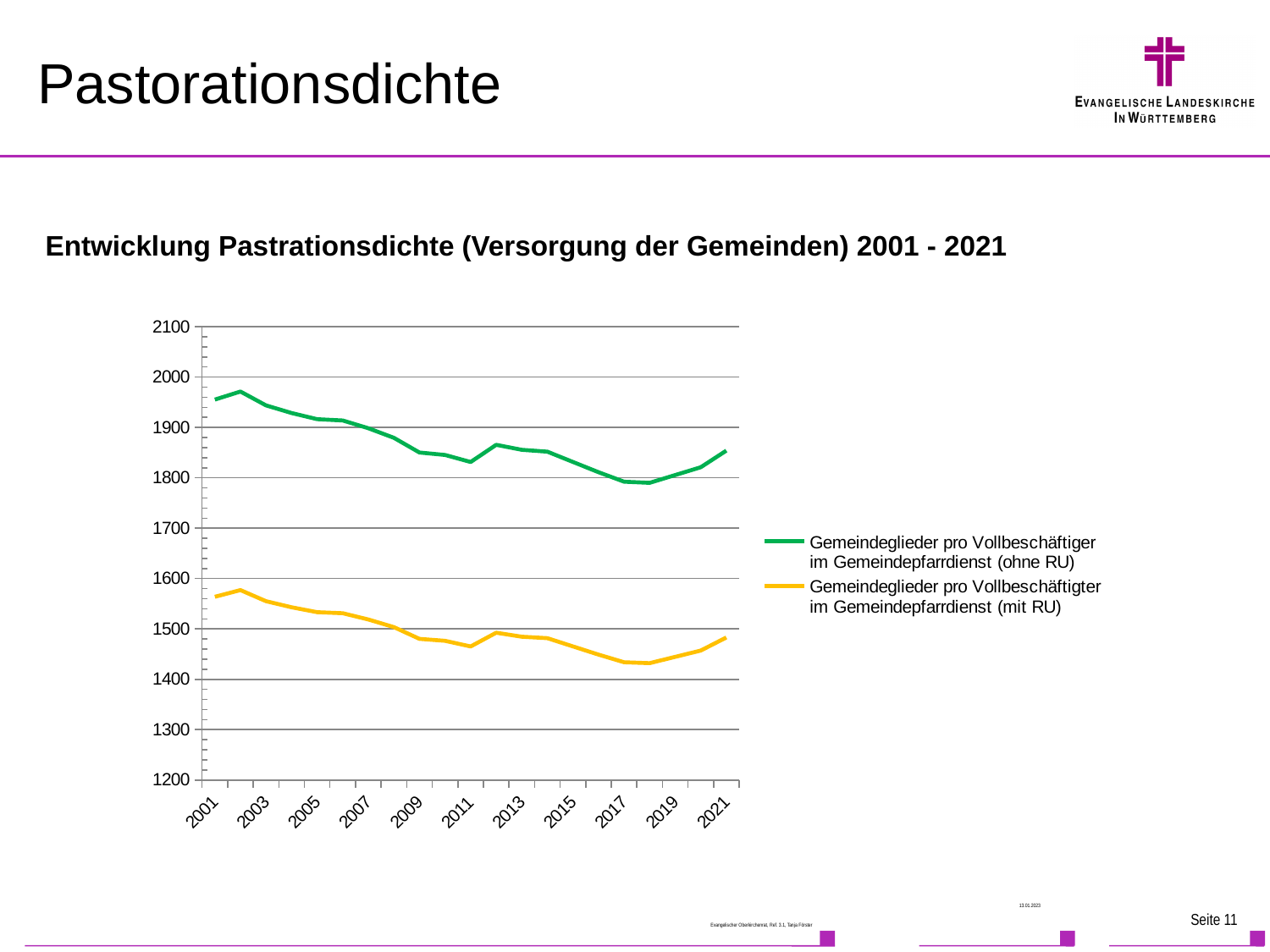
How many year labels are printed on the x axis? 11 Do the values of the 'ohne RU' series rise or fall from 2001 to 2017? fall Is the value for 'Gemeindeglieder pro Vollbeschäftigter im Gemeindepfarrdienst (mit RU)' in 2017 greater or less than 1500? less Is the value for 'Gemeindeglieder pro Vollbeschäftiger im Gemeindepfarrdienst (ohne RU)' in 2021 greater or less than 1900? less In 2011, which series has the larger value: 'ohne RU' or 'mit RU'? ohne RU What kind of chart is shown on the slide? line chart Is the value for 'Gemeindeglieder pro Vollbeschäftiger im Gemeindepfarrdienst (ohne RU)' in 2001 greater or less than 1900? greater What is the title printed above the chart? Entwicklung Pastrationsdichte (Versorgung der Gemeinden) 2001 - 2021 Which colour is used for the series 'Gemeindeglieder pro Vollbeschäftigter im Gemeindepfarrdienst (mit RU)'? yellow How many series does the legend list? 2 Do the values of the 'mit RU' series rise or fall from 2018 to 2021? rise